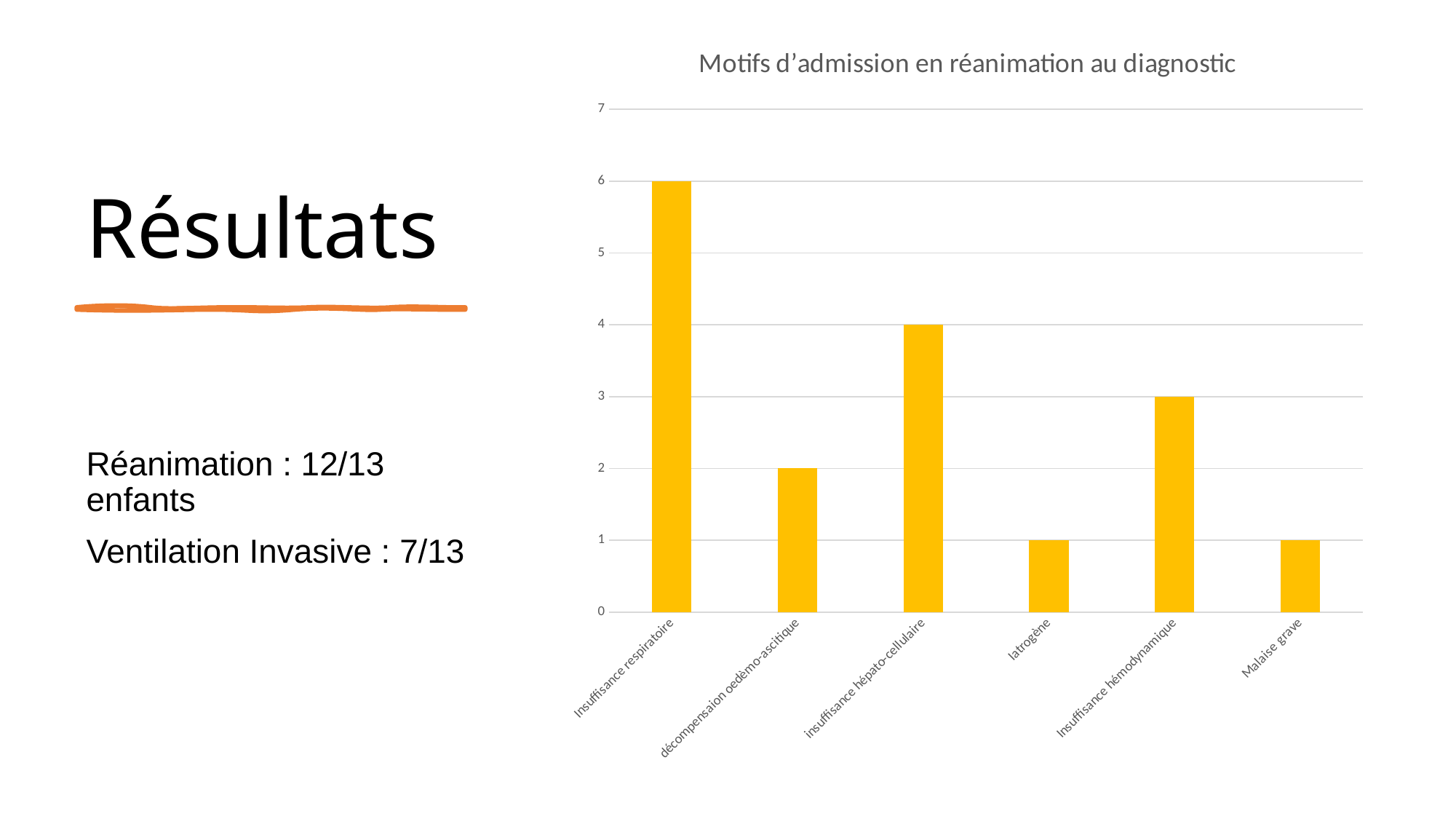
What is the title of the chart? Motifs d'admission en réanimation au diagnostic What is the value for décompensaion oedèmo-ascitique? 2 What is the value for insuffisance hépato-cellulaire? 4 Which is larger, the value for Insuffisance hémodynamique or the value for décompensaion oedèmo-ascitique? Insuffisance hémodynamique What is the value for Insuffisance hémodynamique? 3 How many categories are shown on the x axis? 6 Is the value for Insuffisance respiratoire greater or less than 5? greater What is the difference between the values for Insuffisance respiratoire and insuffisance hépato-cellulaire? 2 What is the highest value shown on the y axis? 7 What is the value for Insuffisance respiratoire? 6 What kind of chart is shown on the slide? bar chart Which category has the highest value? Insuffisance respiratoire